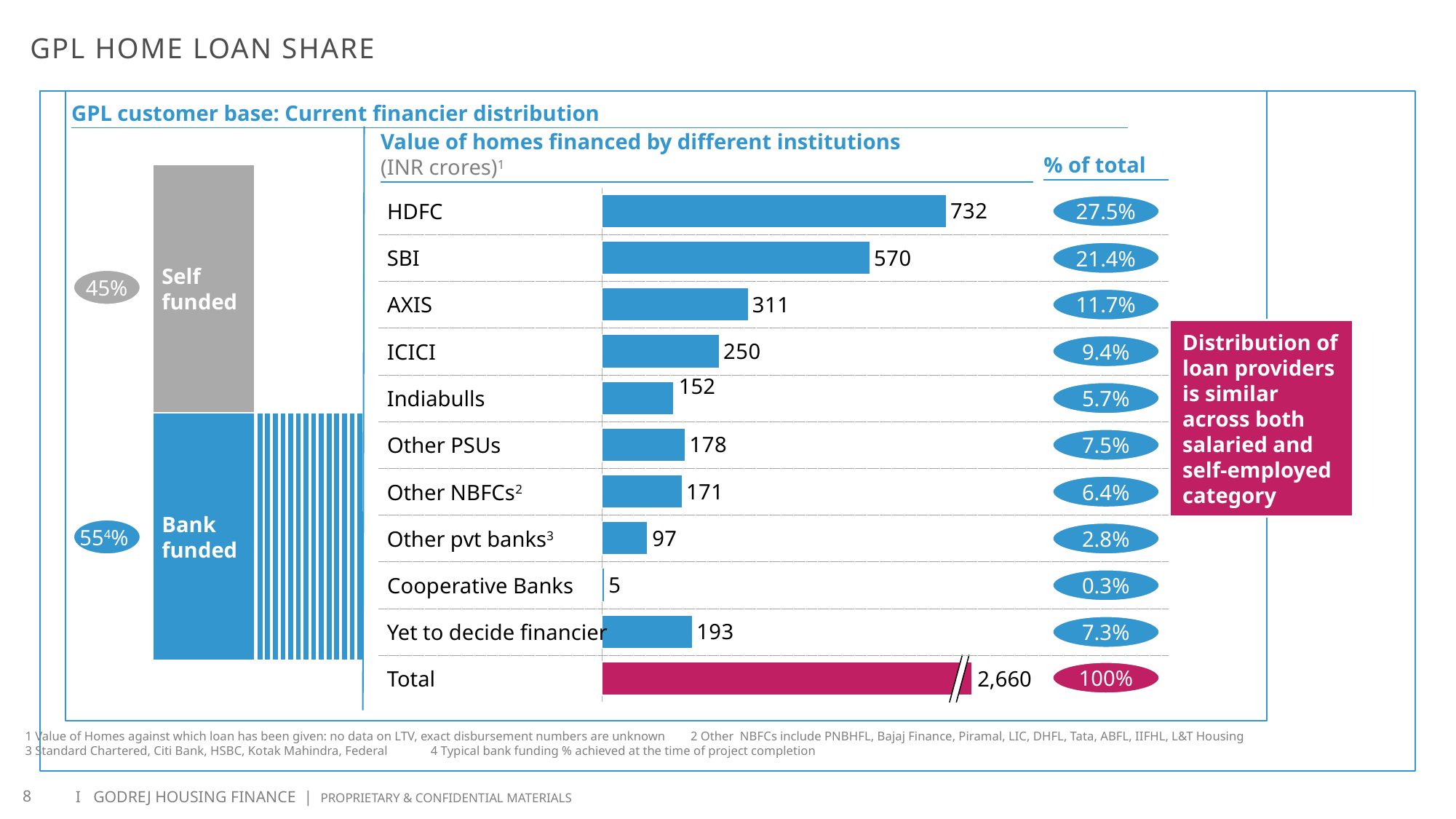
In the 'Value of homes financed by different institutions' chart, what is the difference between the values for HDFC and SBI? 162 In the 'Value of homes financed by different institutions' chart, what is the value for Indiabulls? 152 In the 'Value of homes financed by different institutions' chart, what is the Total value shown? 2,660 In the 'Value of homes financed by different institutions' chart, how many institution categories are listed, excluding the Total row? 10 In the 'Value of homes financed by different institutions' chart, what percentage of the total does SBI account for? 21.4% In the 'Value of homes financed by different institutions' chart, which is larger, the value for Other PSUs or the value for Other NBFCs? Other PSUs In the 'Value of homes financed by different institutions' chart, which institution has the highest value? HDFC In the stacked bar on the left of the slide, what share is Self funded? 45% In the 'Value of homes financed by different institutions' chart, what is the value for HDFC? 732 In the 'Value of homes financed by different institutions' chart, what unit is stated for the values? INR crores What kind of chart is the 'Value of homes financed by different institutions' chart? Bar chart In the 'Value of homes financed by different institutions' chart, which institution has the lowest value? Cooperative Banks